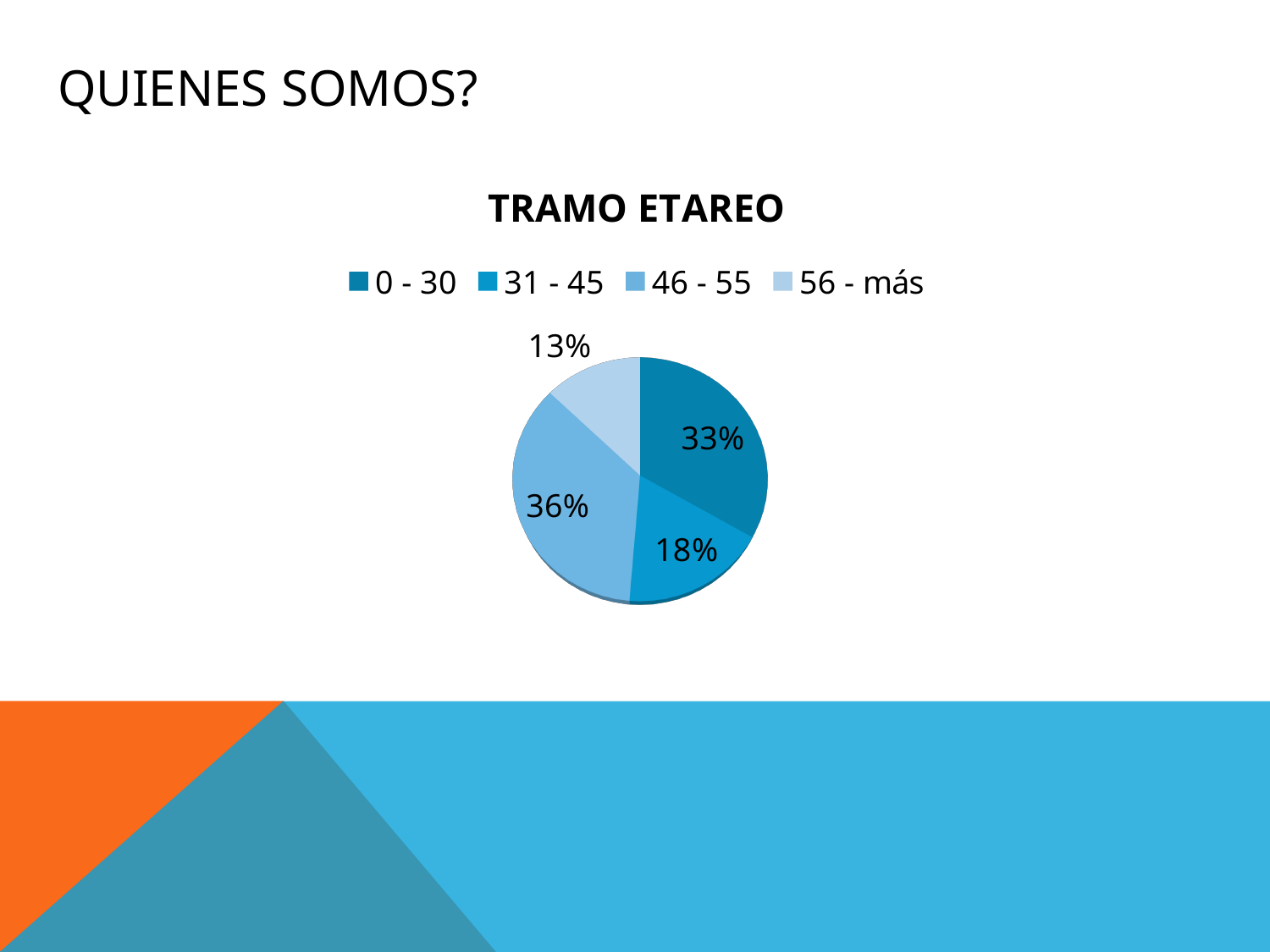
What kind of chart is shown on the slide? pie chart What is the difference in percentage points between the 46 - 55 and 31 - 45 slices? 18 What share of the pie does the 0 - 30 age group represent? 33% What share of the pie does the 56 - más age group represent? 13% Which age group has the largest share of the pie? 46 - 55 Which slice is larger, 0 - 30 or 31 - 45? 0 - 30 What is the title of the chart? TRAMO ETAREO How many slices does the pie chart have? 4 Which age group has the smallest share of the pie? 56 - más What share of the pie does the 46 - 55 age group represent? 36% Which age group is shown in the lightest blue colour in the legend? 56 - más